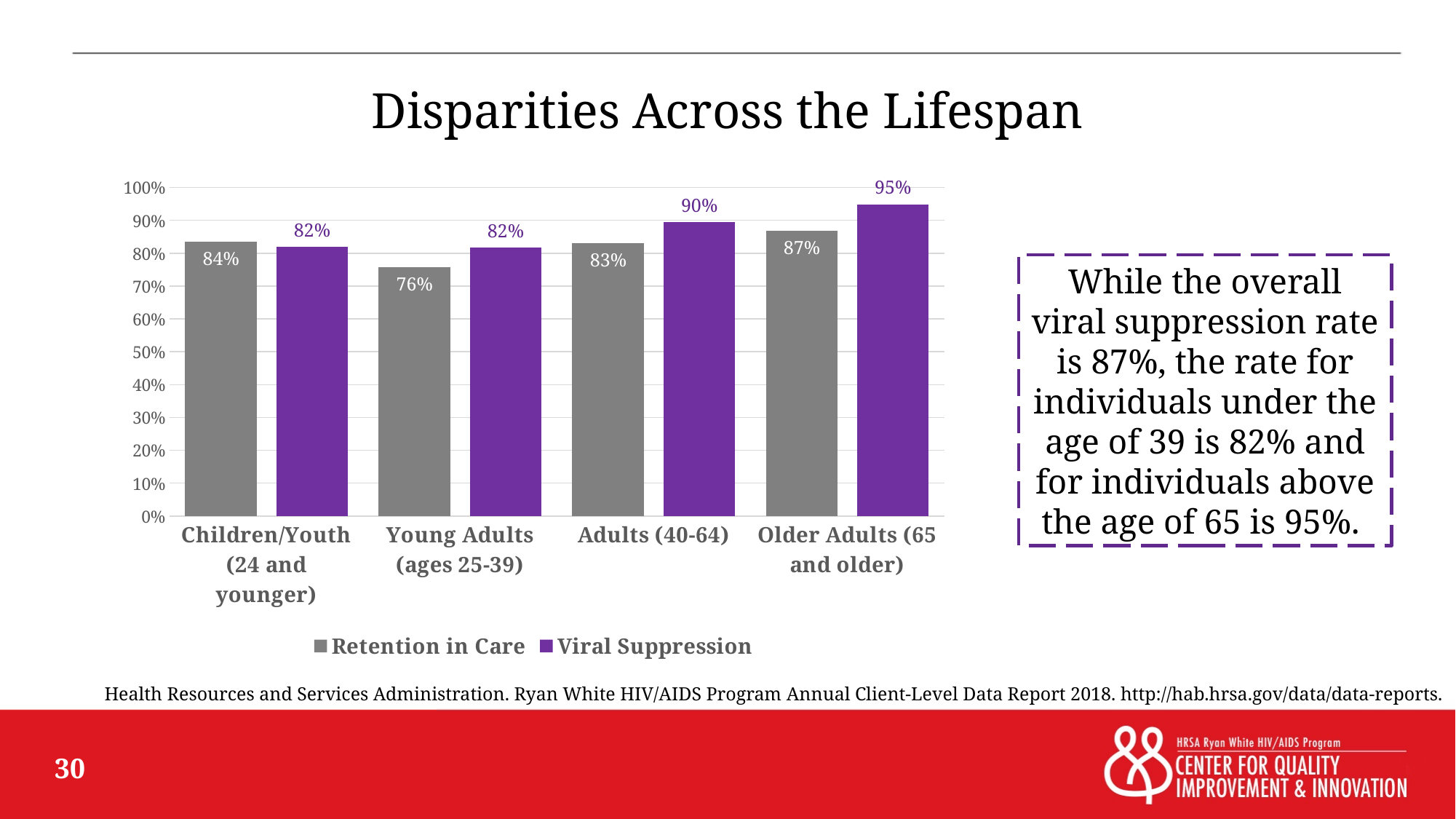
Which age group has the lowest Retention in Care value? Young Adults (ages 25-39) What is the Viral Suppression value for Older Adults (65 and older)? 95% How many age groups are shown on the x axis? 4 Which age group has the highest Viral Suppression value? Older Adults (65 and older) How many series does the legend list? 2 What is the difference between the Viral Suppression values for Older Adults (65 and older) and Young Adults (ages 25-39)? 13% What is the Retention in Care value for Adults (40-64)? 83% What is the Retention in Care value for Young Adults (ages 25-39)? 76% What is the title of the slide containing the chart? Disparities Across the Lifespan What is the Viral Suppression value for Children/Youth (24 and younger)? 82% What kind of chart is shown on the slide? Bar chart Which is larger for Older Adults (65 and older): Retention in Care or Viral Suppression? Viral Suppression